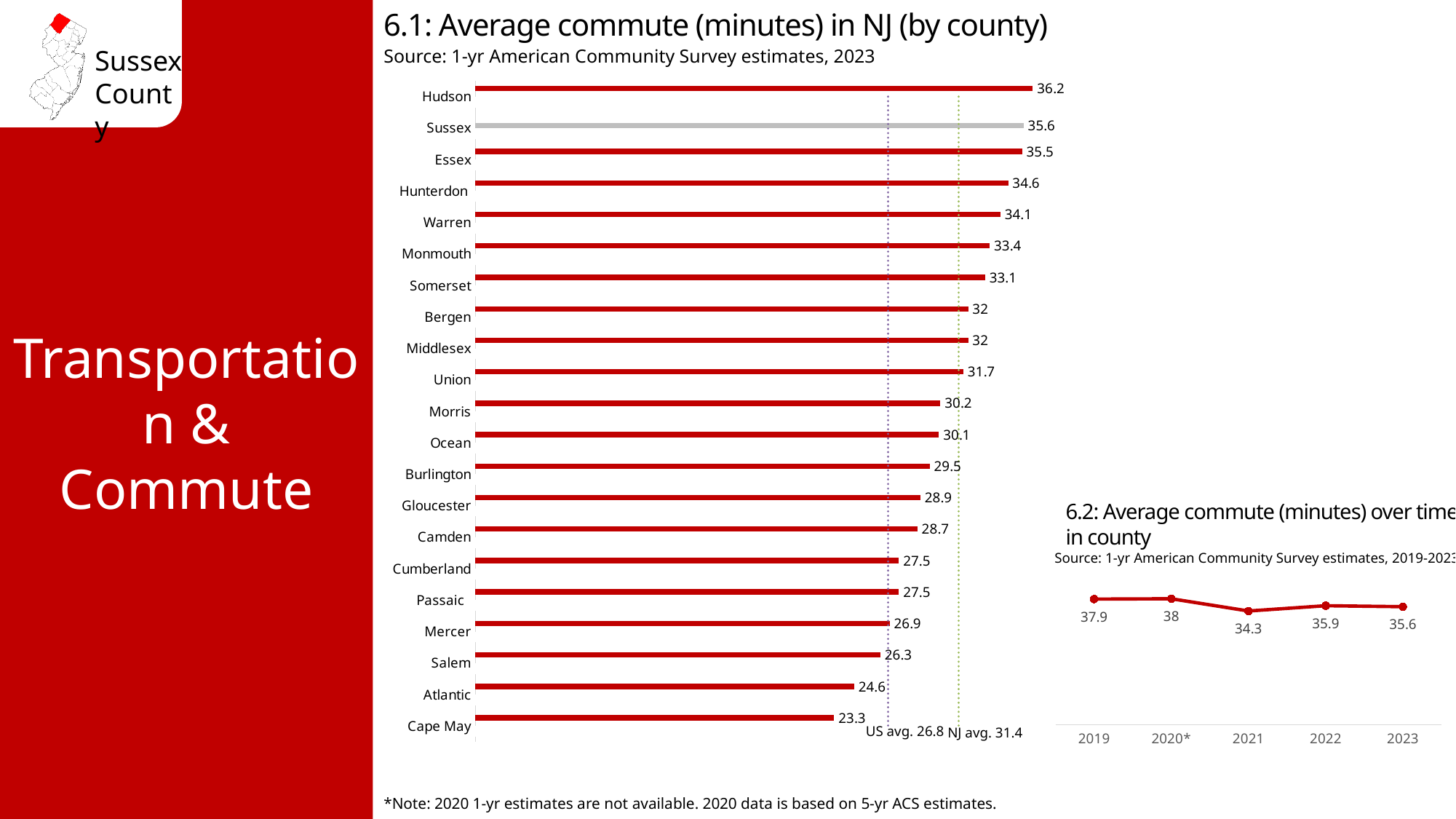
In chart 6.1 (Average commute in NJ by county), how many counties are plotted? 21 In chart 6.2 (Average commute over time in county), what was the average commute in 2021? 34.3 What type of chart is chart 6.2 (Average commute over time in county)? Line chart In chart 6.2 (Average commute over time in county), what is the difference between the 2019 and 2023 values? 2.3 In chart 6.2 (Average commute over time in county), which year had the highest average commute? 2020* What type of chart is chart 6.1 (Average commute in NJ by county)? Bar chart In chart 6.1 (Average commute in NJ by county), what is the average commute for Sussex? 35.6 In chart 6.1 (Average commute in NJ by county), which has a longer average commute, Morris or Salem? Morris In chart 6.1 (Average commute in NJ by county), what is the NJ average commute shown by the dotted reference line? 31.4 In chart 6.1 (Average commute in NJ by county), which county has the highest average commute? Hudson In chart 6.1 (Average commute in NJ by county), what is the difference between Hudson's and Cape May's average commute? 12.9 In chart 6.1 (Average commute in NJ by county), which county has the lowest average commute? Cape May